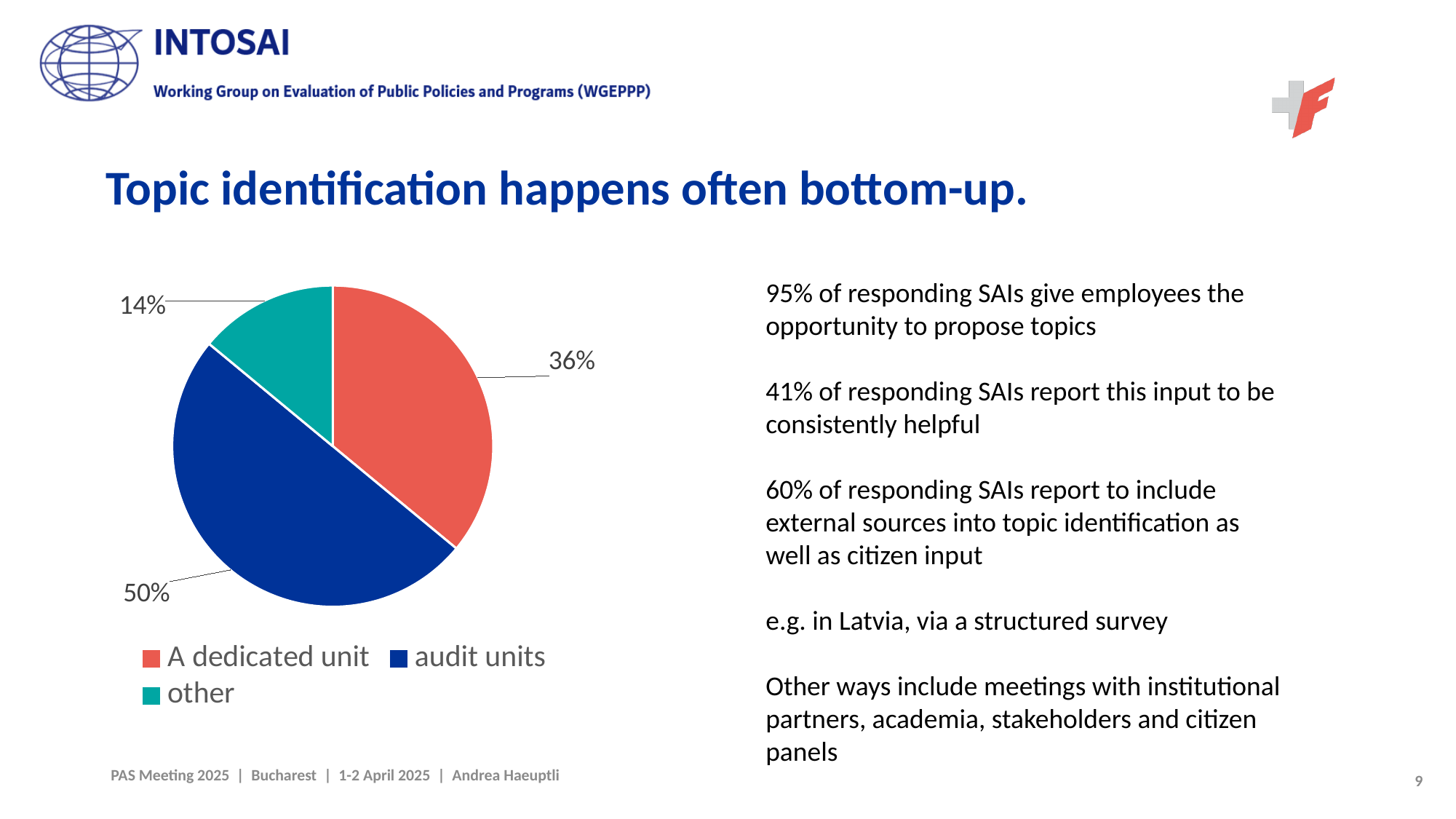
What share of the pie does "other" represent? 14% What share of the pie does "A dedicated unit" represent? 36% What is the difference in percentage points between "A dedicated unit" and "other"? 22 What share of the pie does "audit units" represent? 50% What kind of chart is shown on the slide? pie chart What colour is the slice for "other"? teal Which category has the largest slice of the pie? audit units What is the difference in percentage points between "audit units" and "A dedicated unit"? 14 Which category has the smallest slice of the pie? other What colour is the slice for "audit units"? blue Which is larger, the slice for "A dedicated unit" or the slice for "other"? A dedicated unit How many categories does the pie chart show? 3